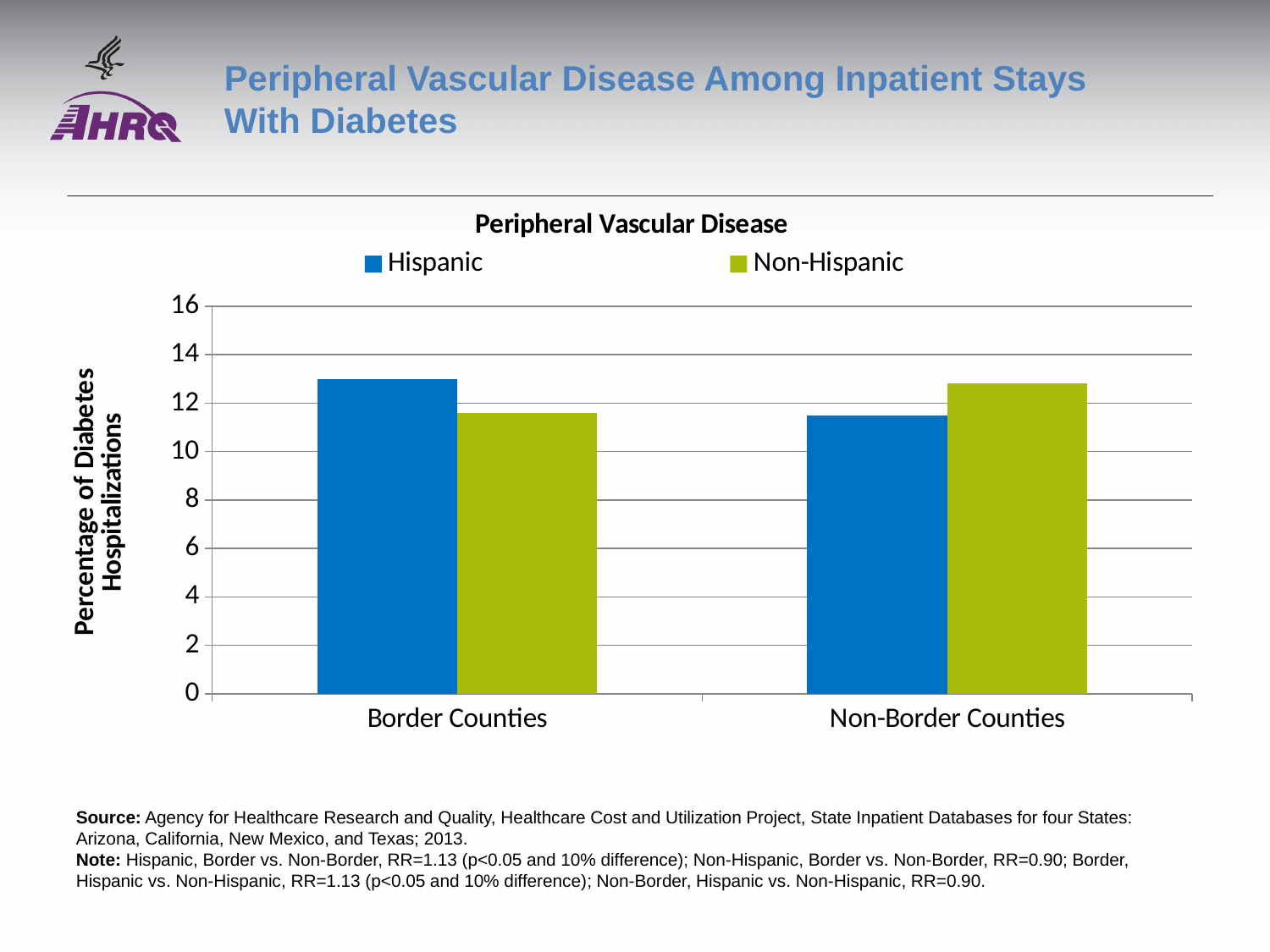
Is the Hispanic value for Non-Border Counties greater or less than 12? less What is the title of the chart? Peripheral Vascular Disease How many series does the chart legend list? 2 How many county categories are shown on the x axis? 2 Is the Non-Hispanic value for Non-Border Counties greater or less than 12? greater Is the Non-Hispanic value for Border Counties greater or less than 12? less In Non-Border Counties, which group has the higher value, Hispanic or Non-Hispanic? Non-Hispanic For the Hispanic series, which is higher, Border Counties or Non-Border Counties? Border Counties What kind of chart is shown on the slide? bar chart In Border Counties, which group has the higher value, Hispanic or Non-Hispanic? Hispanic What is the label on the vertical axis? Percentage of Diabetes Hospitalizations